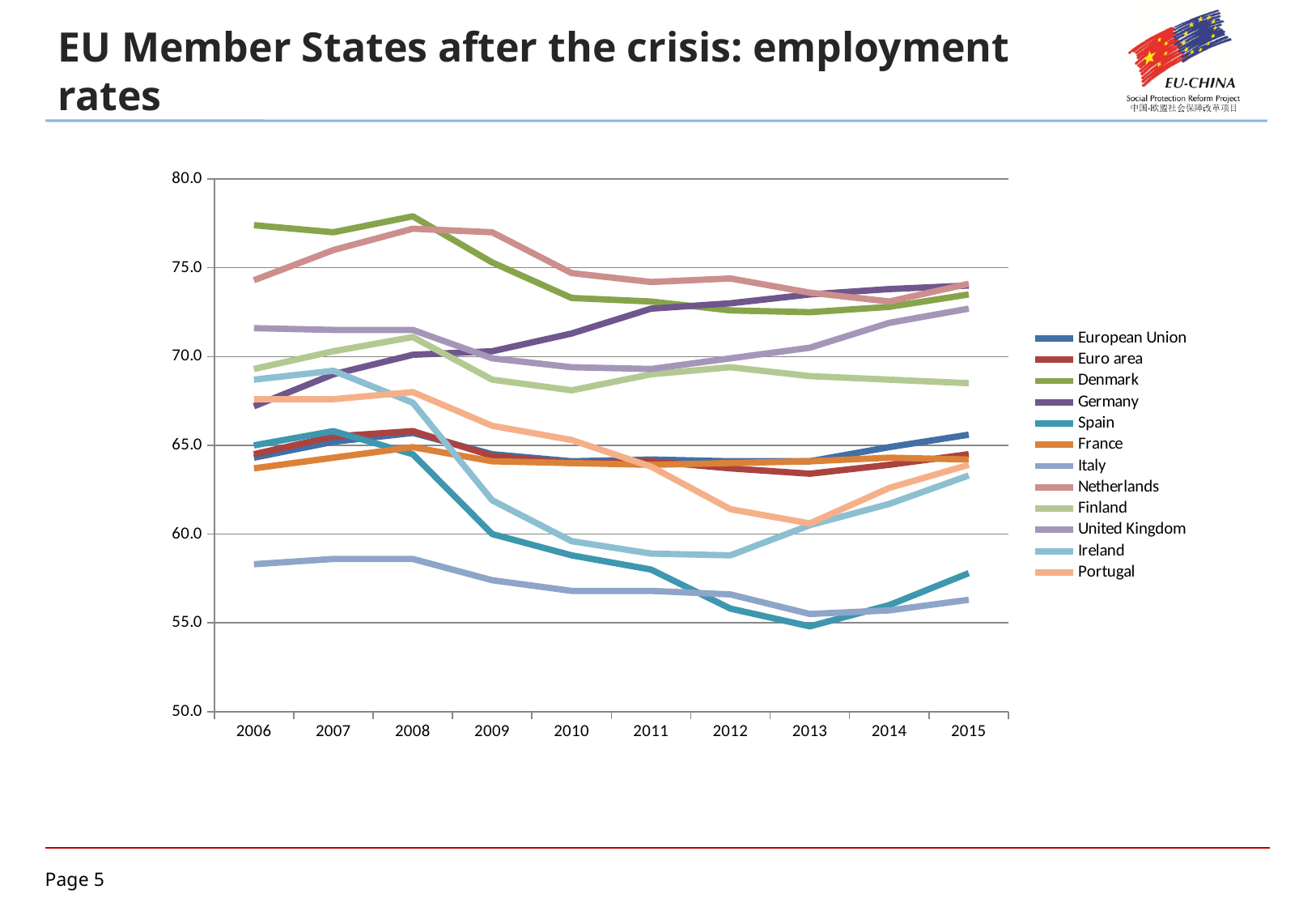
Is the value for Italy in 2006 greater or less than 60? less What is the title of the slide? EU Member States after the crisis: employment rates How many series does the legend list? 12 How many years are shown along the x axis? 10 Does the line for Germany rise or fall from 2006 to 2015? rise Is the value for Finland in 2015 greater or less than 70? less Is the value for Denmark in 2008 greater or less than 75? greater Which country has the lowest employment rate in 2006? Italy Which country has the highest employment rate in 2006? Denmark What kind of chart is shown on the slide? line chart In 2015, which is higher: Germany or United Kingdom? Germany